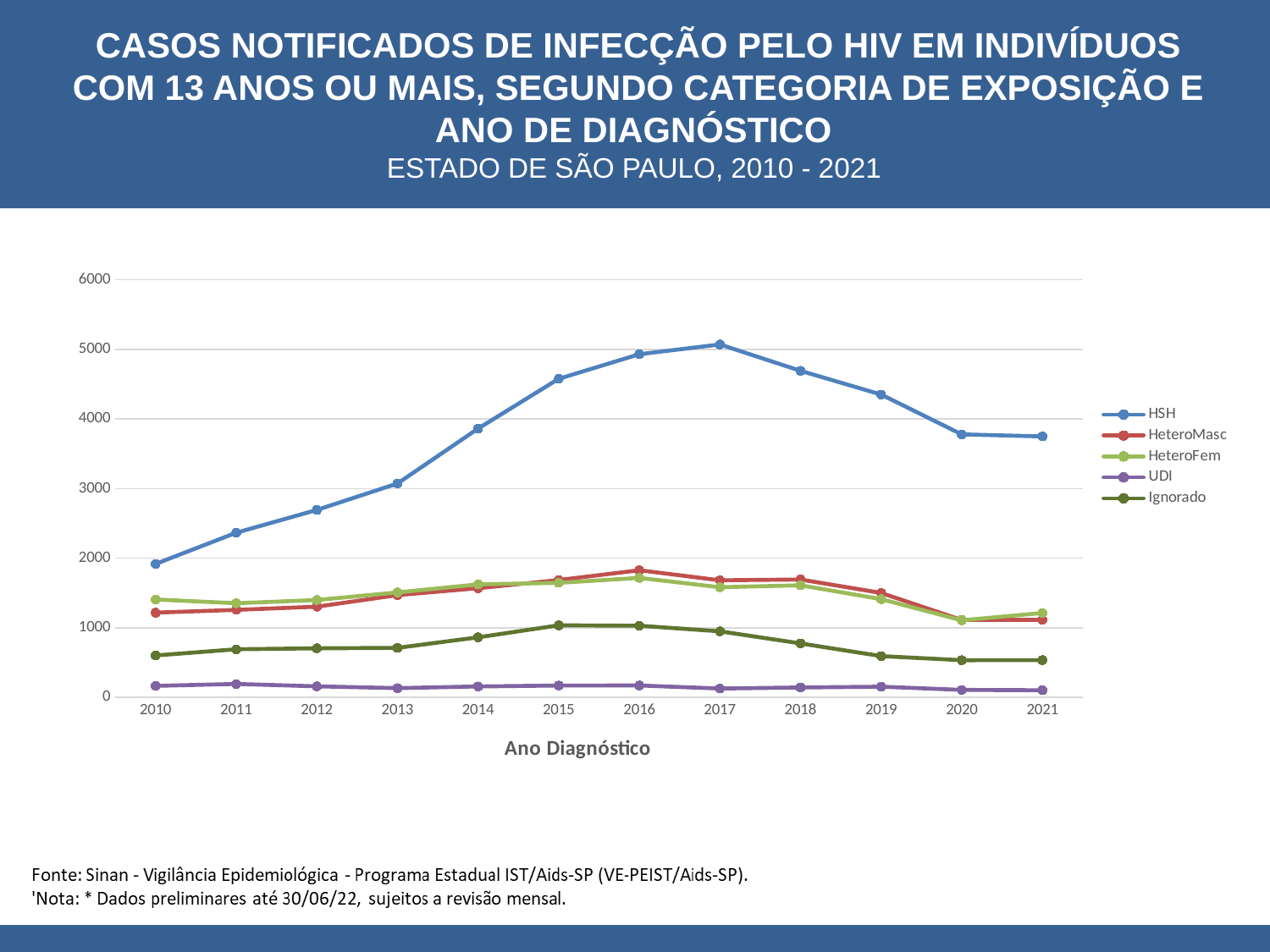
What kind of chart is shown on the slide? line chart How many years are plotted along the x axis? 12 Do the HSH values rise or fall from 2010 to 2017? rise Is the value for HSH in 2015 greater or less than 4000? greater Which series has the lowest values across the chart? UDI Do the HSH values rise or fall from 2017 to 2021? fall How many series does the legend list? 5 In 2010, which is larger: the value for Ignorado or the value for UDI? Ignorado In which year does the HSH series reach its peak? 2017 Which series has the highest values across the chart? HSH What is the title of the x axis? Ano Diagnóstico Is the value for HSH in 2010 greater or less than 2000? less